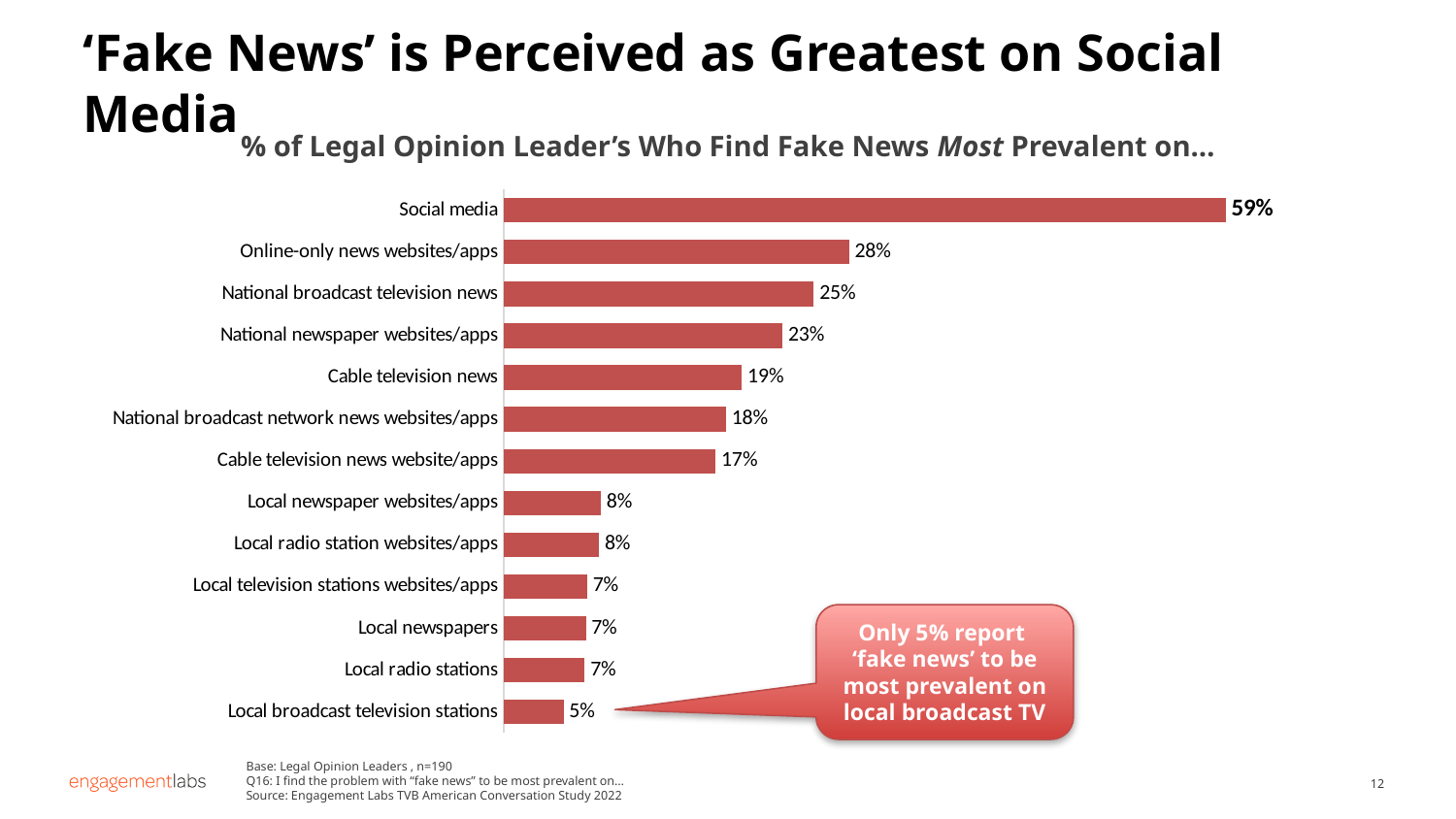
What is the value for Cable television news? 19% Which category has the lowest value? Local broadcast television stations What is the value for National newspaper websites/apps? 23% What percentage of Legal Opinion Leaders find fake news most prevalent on Social media? 59% Which is larger: the value for Cable television news or the value for Cable television news website/apps? Cable television news How many categories are shown in the chart? 13 What is the difference between the values for Social media and Online-only news websites/apps? 31 percentage points What is the difference between National broadcast television news and Local broadcast television stations? 20 percentage points Which category has the highest value? Social media What is the value for National broadcast network news websites/apps? 18% What kind of chart is shown on the slide? Bar chart What is the title of the chart? % of Legal Opinion Leader's Who Find Fake News Most Prevalent on...